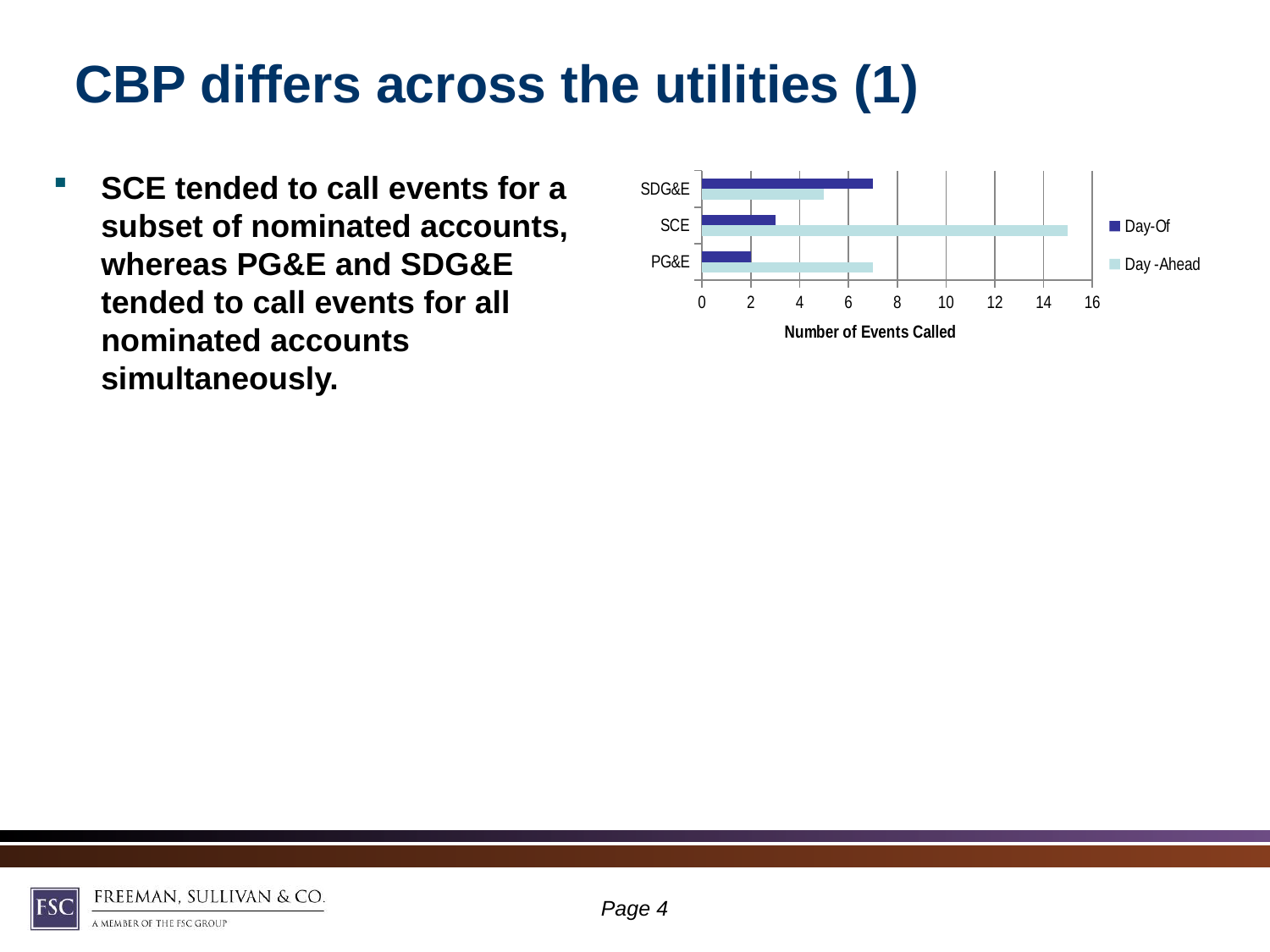
Which utility has the highest Day-Ahead value? SCE Is the Day-Of value for SDG&E greater or less than 6? greater Which utility has the lowest Day-Of value? PG&E Which utility has the highest Day-Of value? SDG&E Is the Day-Ahead value for PG&E greater or less than 8? less How many utilities (categories) are shown on the chart? 3 How many series does the chart's legend list? 2 For SDG&E, which is larger: the Day-Of value or the Day-Ahead value? Day-Of For SCE, which is larger: the Day-Of value or the Day-Ahead value? Day-Ahead Is the Day-Ahead value for SCE greater or less than 14? greater What is the title of the chart's horizontal axis? Number of Events Called What kind of chart is shown on the slide? Bar chart